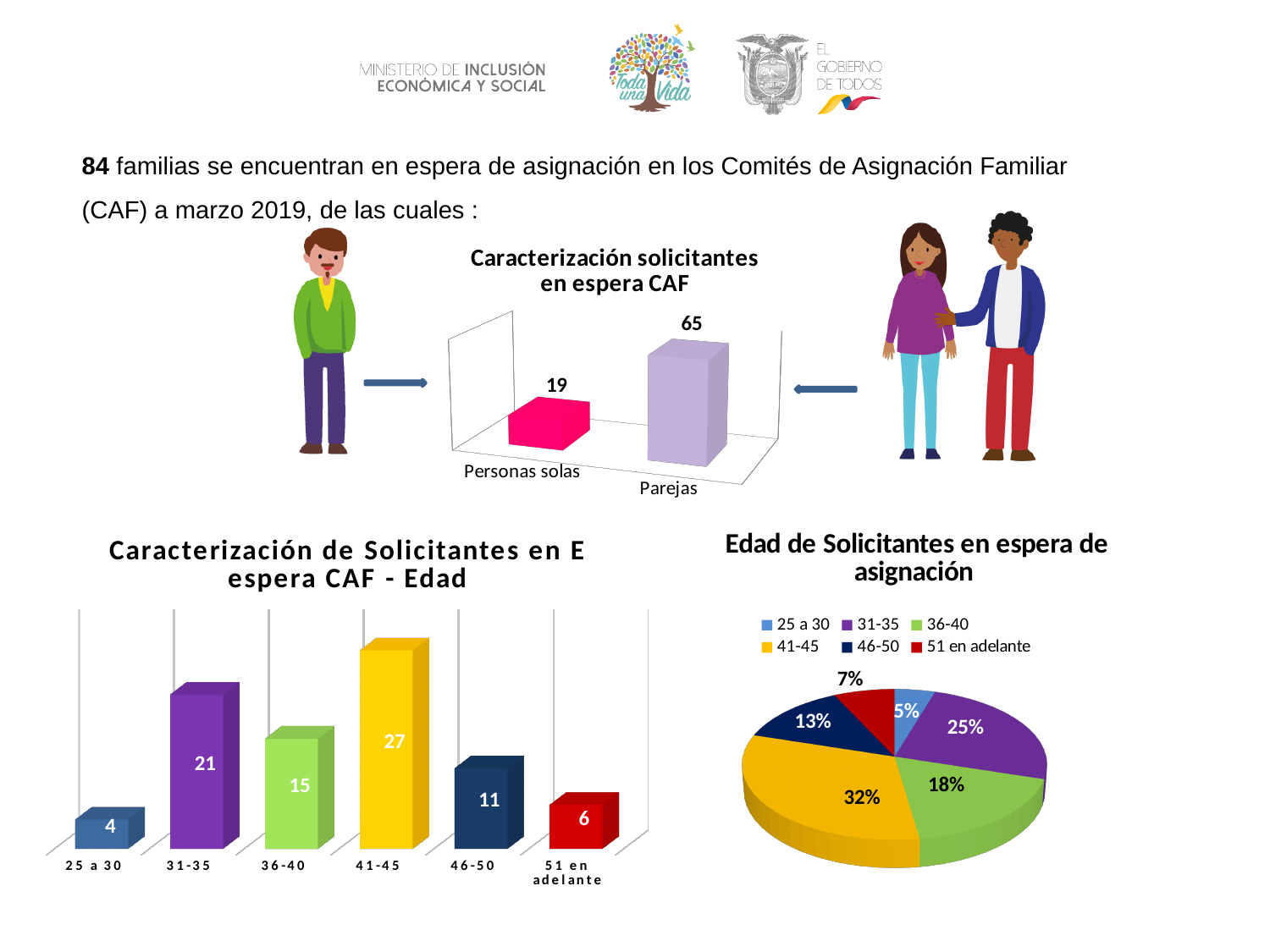
In the chart titled 'Edad de Solicitantes en espera de asignación', how many entries does the legend list? 6 In the chart titled 'Caracterización de Solicitantes en E espera CAF - Edad', what is the value for 41-45? 27 In the chart titled 'Caracterización de Solicitantes en E espera CAF - Edad', which age group has the highest value? 41-45 In the chart titled 'Edad de Solicitantes en espera de asignación', what share does the 41-45 group have? 32% In the chart titled 'Caracterización solicitantes en espera CAF', what is the difference between Parejas and Personas solas? 46 In the chart titled 'Caracterización solicitantes en espera CAF', what kind of chart is shown? bar chart In the chart titled 'Caracterización de Solicitantes en E espera CAF - Edad', what is the difference between 31-35 and 46-50? 10 In the chart titled 'Caracterización de Solicitantes en E espera CAF - Edad', how many age categories are shown? 6 In the chart titled 'Caracterización solicitantes en espera CAF', what is the value for Personas solas? 19 In the chart titled 'Caracterización solicitantes en espera CAF', what is the value for Parejas? 65 In the chart titled 'Edad de Solicitantes en espera de asignación', which is larger, the 31-35 slice or the 36-40 slice? 31-35 In the chart titled 'Caracterización de Solicitantes en E espera CAF - Edad', which age group has the lowest value? 25 a 30